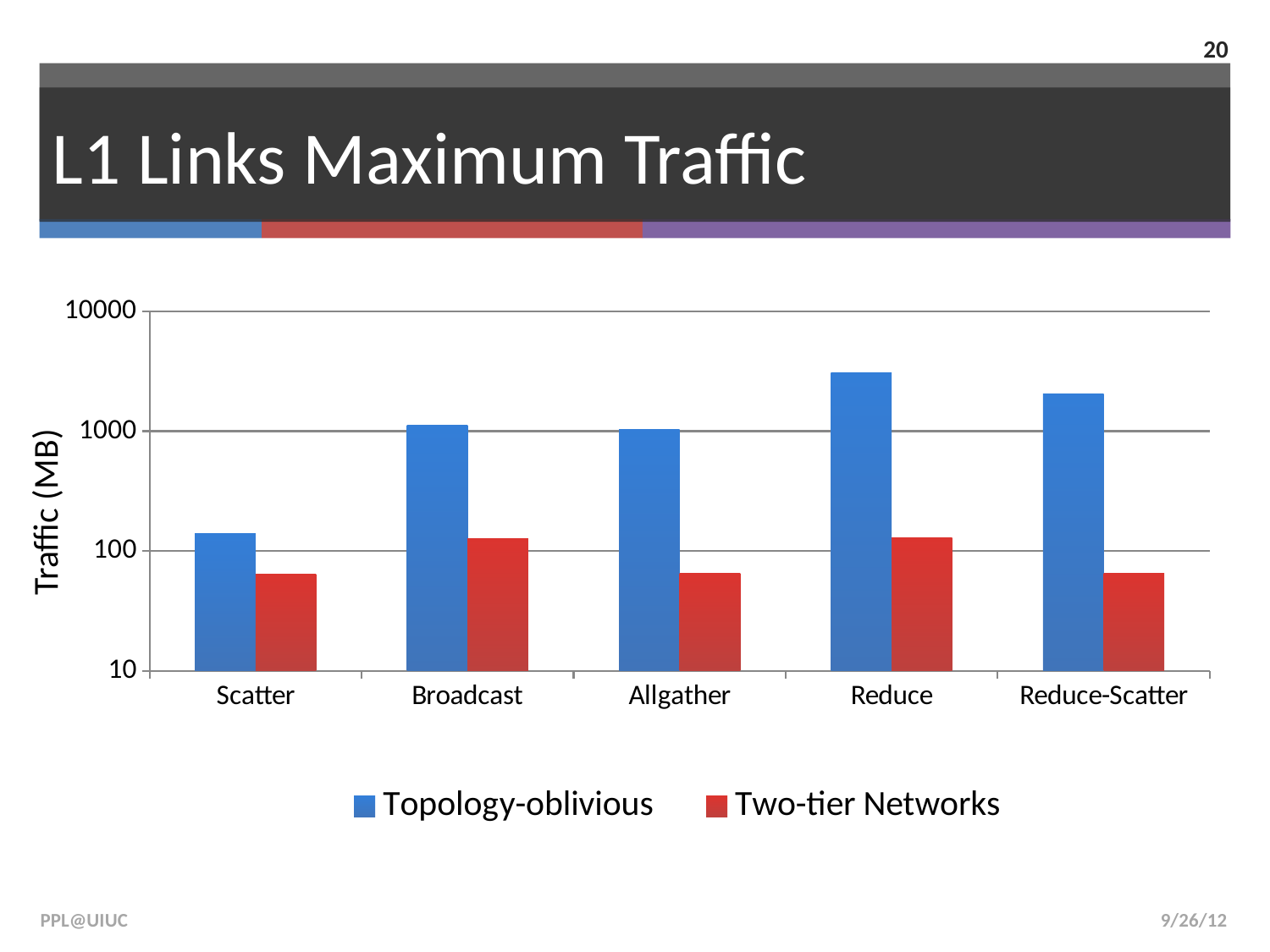
How many series does the legend list? 2 What kind of chart is shown on the slide? bar chart Is the Two-tier Networks value for Scatter greater or less than 100? less What is the label on the y axis? Traffic (MB) Which is larger, the Topology-oblivious value for Reduce or for Reduce-Scatter? Reduce Is the Topology-oblivious value for Scatter greater or less than 100? greater Is the Topology-oblivious value for Reduce greater or less than 1000? greater How many categories are shown on the x axis? 5 Which category has the highest Topology-oblivious traffic? Reduce For Broadcast, which series has the larger value, Topology-oblivious or Two-tier Networks? Topology-oblivious Which category has the lowest Topology-oblivious traffic? Scatter